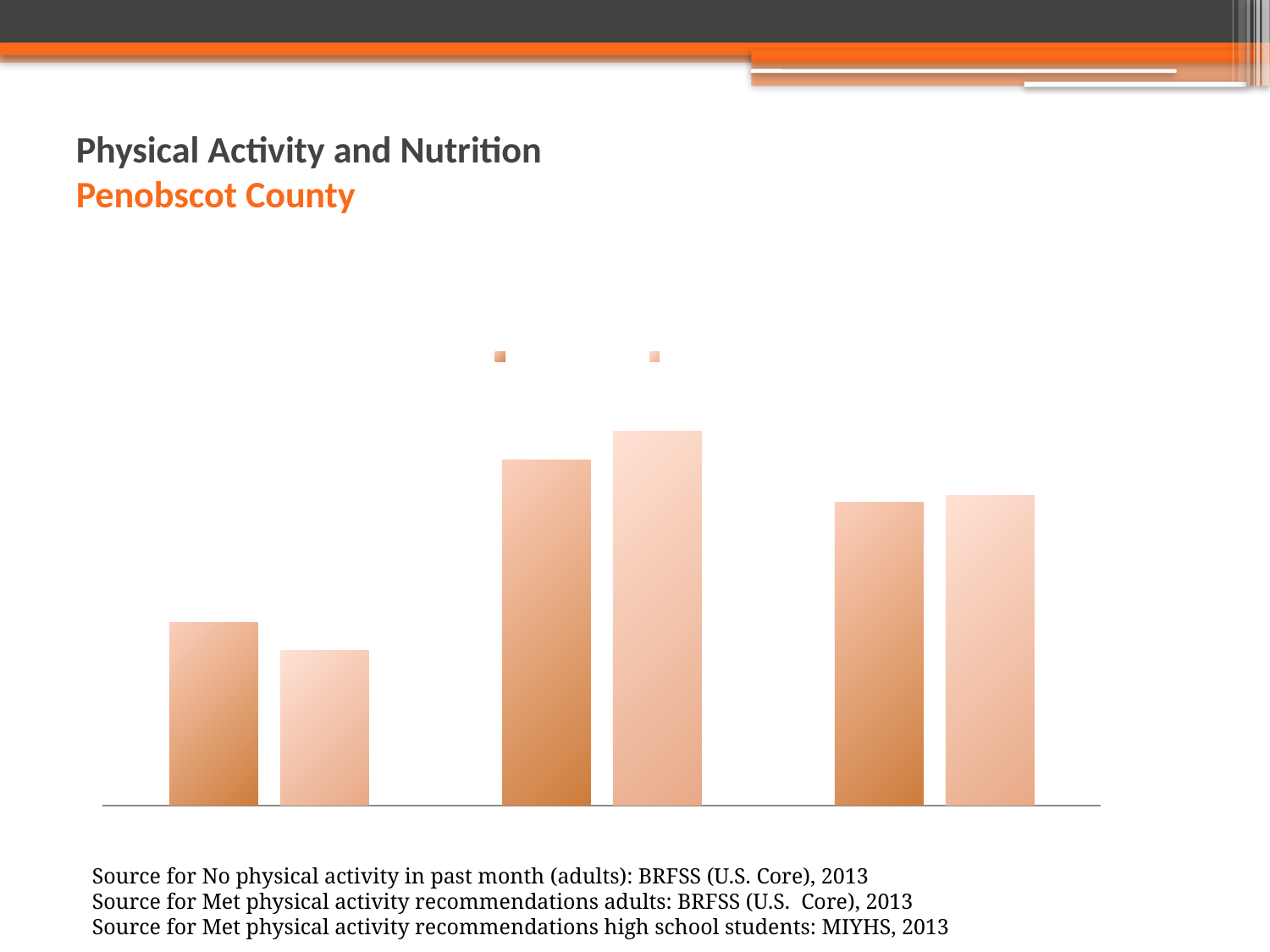
In the middle group, is the darker orange bar or the lighter orange bar taller? the lighter orange bar Which group of bars, counting from the left, has the shortest bars? the first (leftmost) group Which county is named in the slide subtitle? Penobscot County What kind of chart is shown on the slide? bar chart In the leftmost group, is the darker orange bar or the lighter orange bar taller? the darker orange bar What is the title shown above the chart on the slide? Physical Activity and Nutrition How many series does the legend list? 2 How many groups of bars does the chart show? 3 Which group of bars, counting from the left, has the tallest bars? the second (middle) group How many bars are plotted in total on the chart? 6